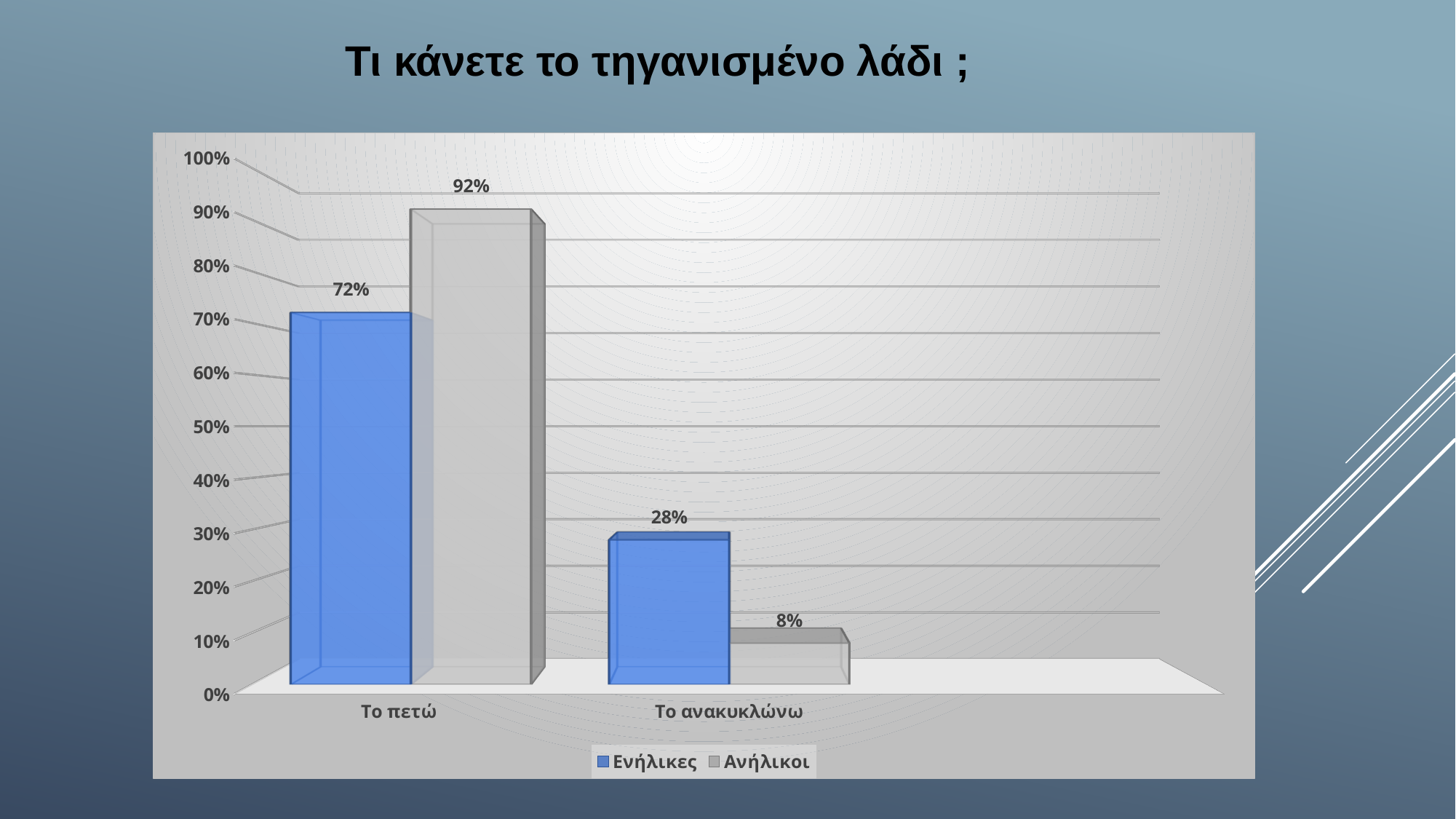
Which is larger: Ενήλικες for Το ανακυκλώνω or Ανήλικοι for Το ανακυκλώνω? Ενήλικες for Το ανακυκλώνω What kind of chart is shown on the slide? Bar chart What is the value for Ενήλικες in the Το πετώ category? 72% How many series does the legend list? 2 What is the value for Ανήλικοι in the Το ανακυκλώνω category? 8% What is the value for Ανήλικοι in the Το πετώ category? 92% How many categories are shown on the x axis? 2 Which series has the lowest value in the Το ανακυκλώνω category? Ανήλικοι What is the value for Ενήλικες in the Το ανακυκλώνω category? 28% What is the difference between the Ανήλικοι and Ενήλικες values for Το πετώ? 20% What is the difference between the Ενήλικες and Ανήλικοι values for Το ανακυκλώνω? 20% Which series has the highest value in the Το πετώ category? Ανήλικοι